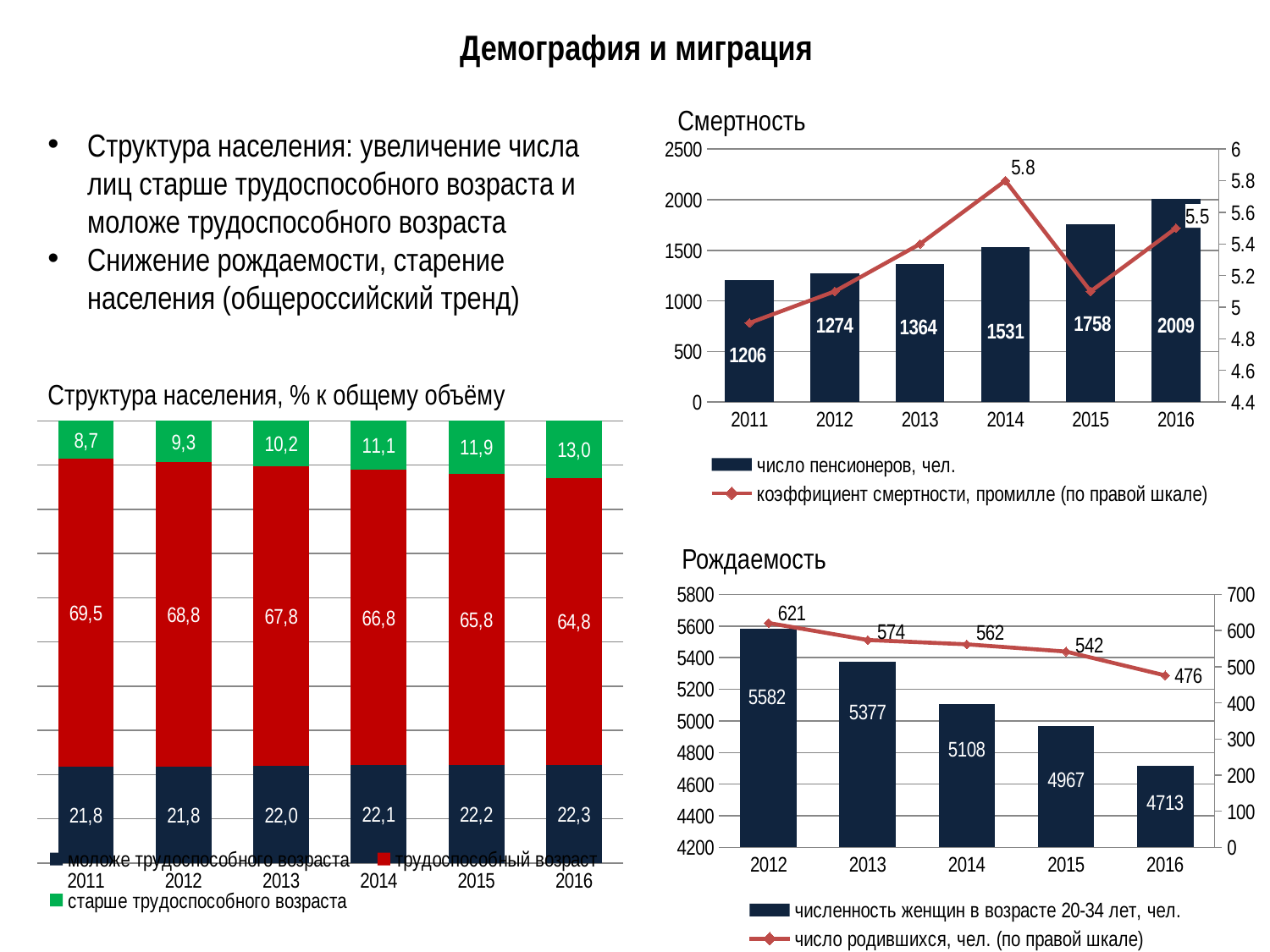
On the Структура населения chart, what is the total of the three segments for 2011? 100,0 On the Рождаемость chart, what is the difference between the численность женщин values for 2012 and 2016? 869 On the Рождаемость chart, how many years are shown on the x axis? 5 On the Смертность chart, which year has the highest число пенсионеров? 2016 On the Структура населения chart, how many series does the legend list? 3 On the Смертность chart, is the коэффициент смертности value for 2011 greater or less than 5 on the right-hand axis? less On the Рождаемость chart, what is the число родившихся value for 2013? 574 On the Рождаемость chart, does the число родившихся line rise or fall from 2012 to 2016? fall On the Смертность chart, what is the difference between the число пенсионеров values for 2016 and 2011? 803 On the Структура населения chart, what is the value for старше трудоспособного возраста in 2016? 13,0 On the Смертность chart, what is the число пенсионеров value for 2014? 1531 On the Смертность chart, what is the коэффициент смертности value labelled for 2014? 5.8